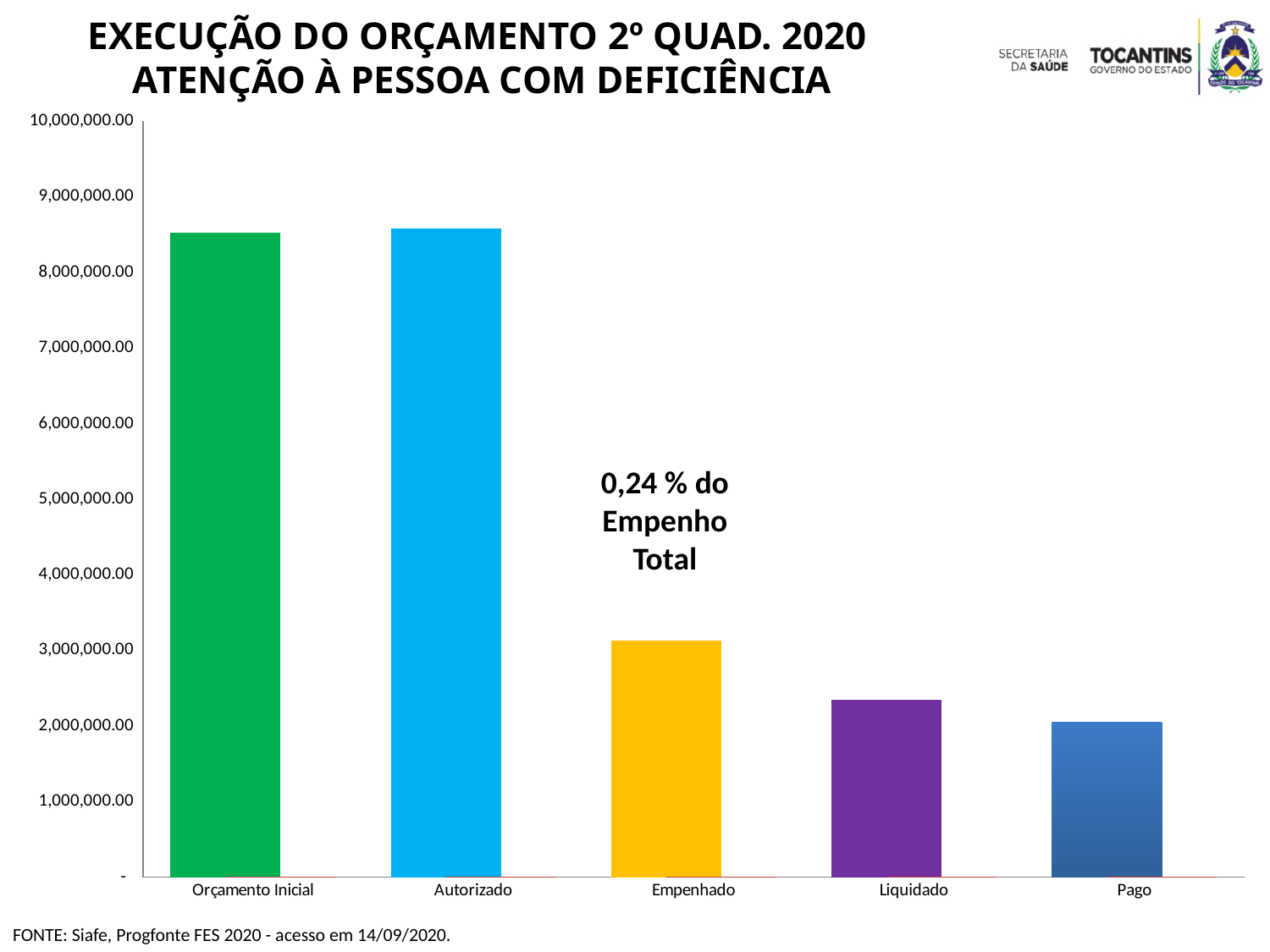
Is the value for Liquidado greater or less than 2,000,000.00? greater Which is larger, the value for Autorizado or the value for Pago? Autorizado Is the value for Orçamento Inicial greater or less than 8,000,000.00? greater How many categories are shown on the x axis of the chart? 5 Which is larger, the value for Empenhado or the value for Liquidado? Empenhado Is the value for Empenhado greater or less than 4,000,000.00? less Which category has the lowest value in the chart? Pago What kind of chart is shown on the slide? bar chart What percentage is stated in the annotation above the Empenhado bar? 0,24 % Do the values generally rise or fall from Autorizado to Pago along the x axis? fall